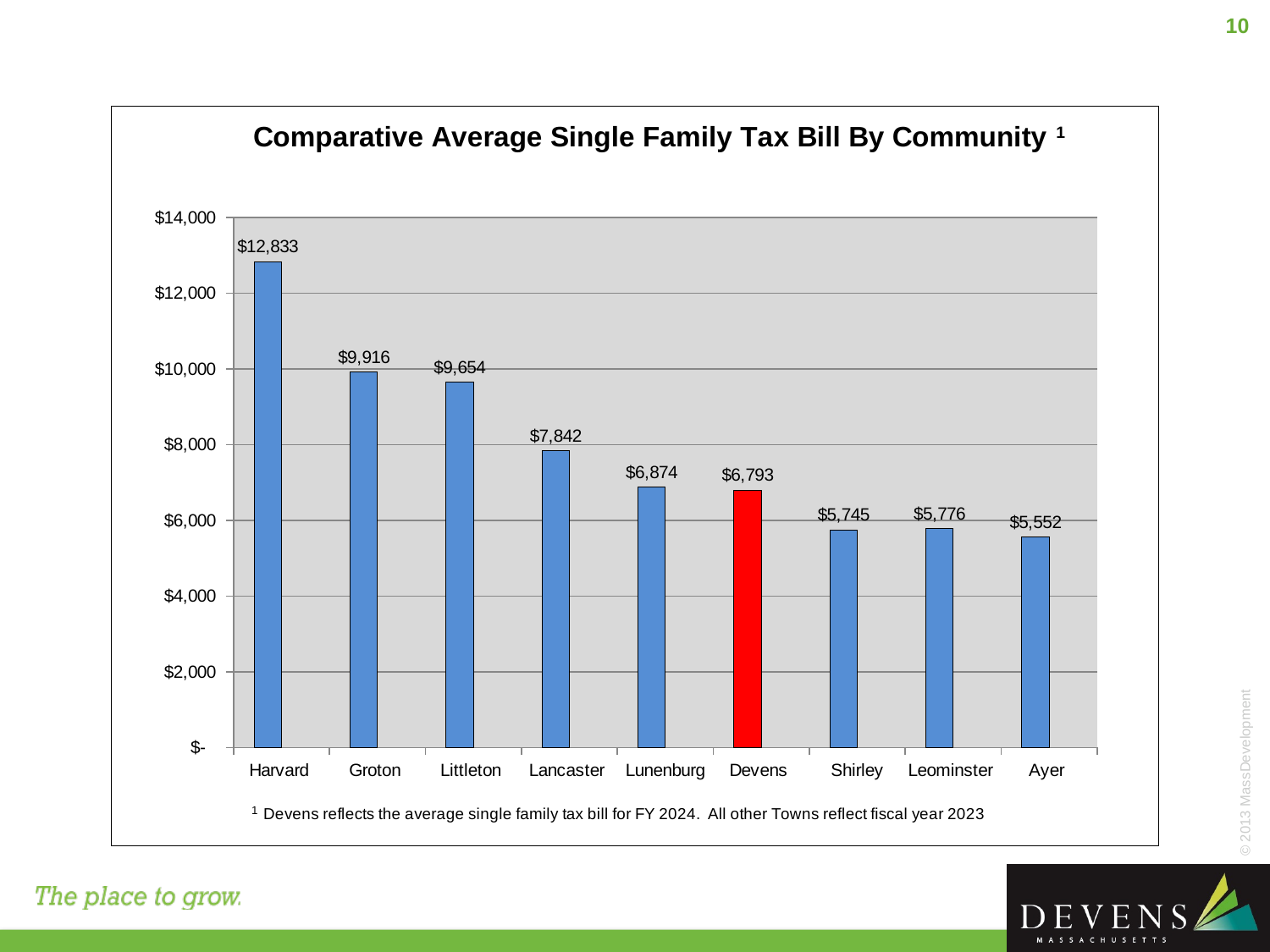
Which community has the lowest average single family tax bill? Ayer What is the average single family tax bill for Harvard? $12,833 Is the value for Littleton greater or less than $10,000? less What is the average single family tax bill for Devens? $6,793 What is the difference between the tax bills for Lunenburg and Devens? $81 Which community's bar is coloured red? Devens What is the average single family tax bill for Leominster? $5,776 Which community has the highest average single family tax bill? Harvard What kind of chart is shown on the slide? bar chart What is the difference between the tax bills for Harvard and Groton? $2,917 Which has a larger average tax bill, Lancaster or Shirley? Lancaster How many communities are shown in the chart? 9